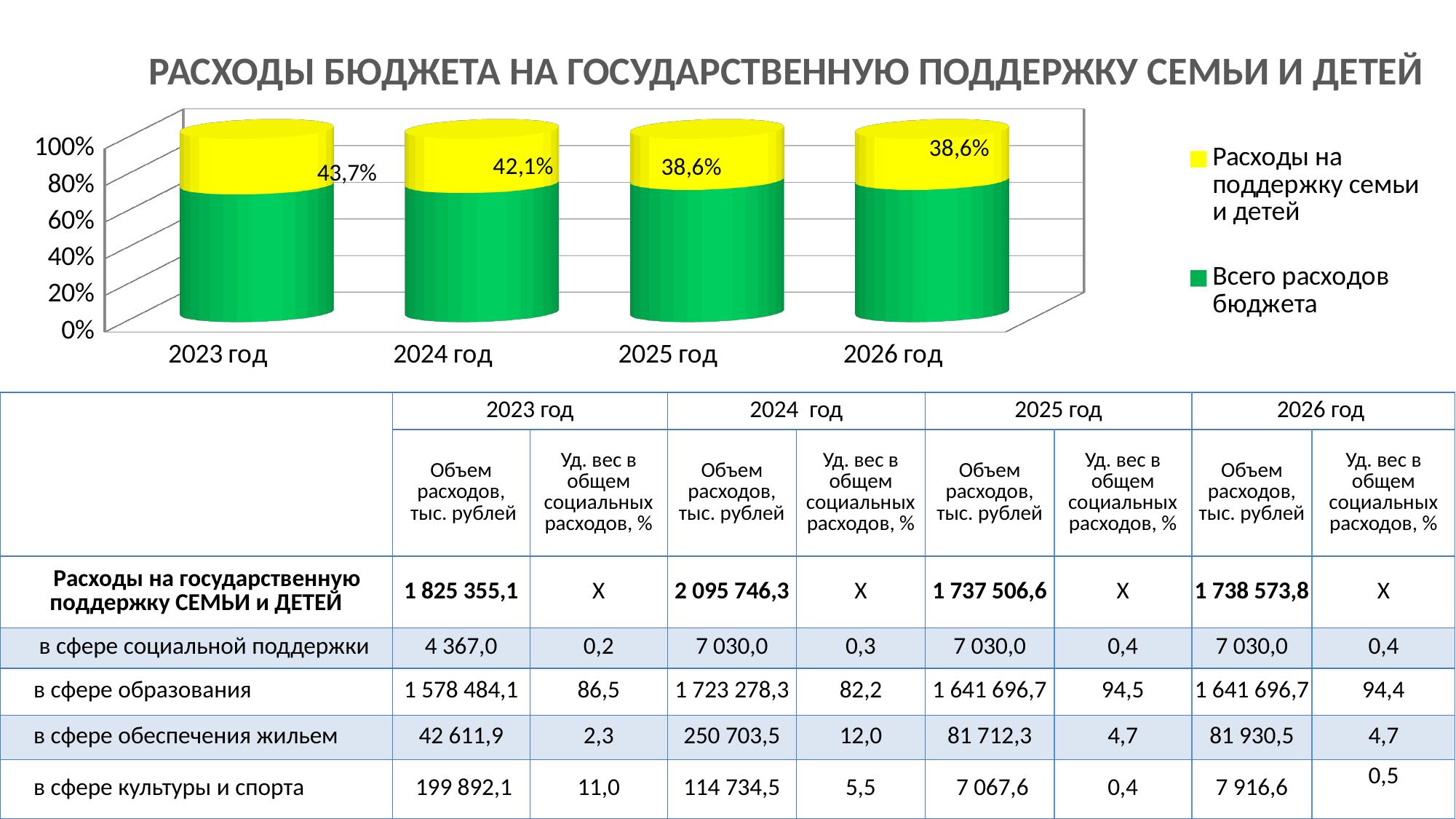
What is the data label shown for 2024 год on the chart? 42,1% What is the data label shown for 2023 год on the chart? 43,7% What is the difference between the labelled percentages for 2023 год and 2024 год? 1,6% Which has the larger labelled percentage on the chart, 2024 год or 2026 год? 2024 год Do the labelled percentages rise or fall from 2023 год to 2026 год? Fall How many series does the chart legend list? 2 What is the data label shown for 2025 год on the chart? 38,6% Which year has the highest labelled percentage on the chart? 2023 год How many years are shown on the x axis of the chart? 4 What kind of chart is shown on the slide? Stacked bar chart What is the data label shown for 2026 год on the chart? 38,6% What is the difference between the labelled percentages for 2023 год and 2025 год? 5,1%